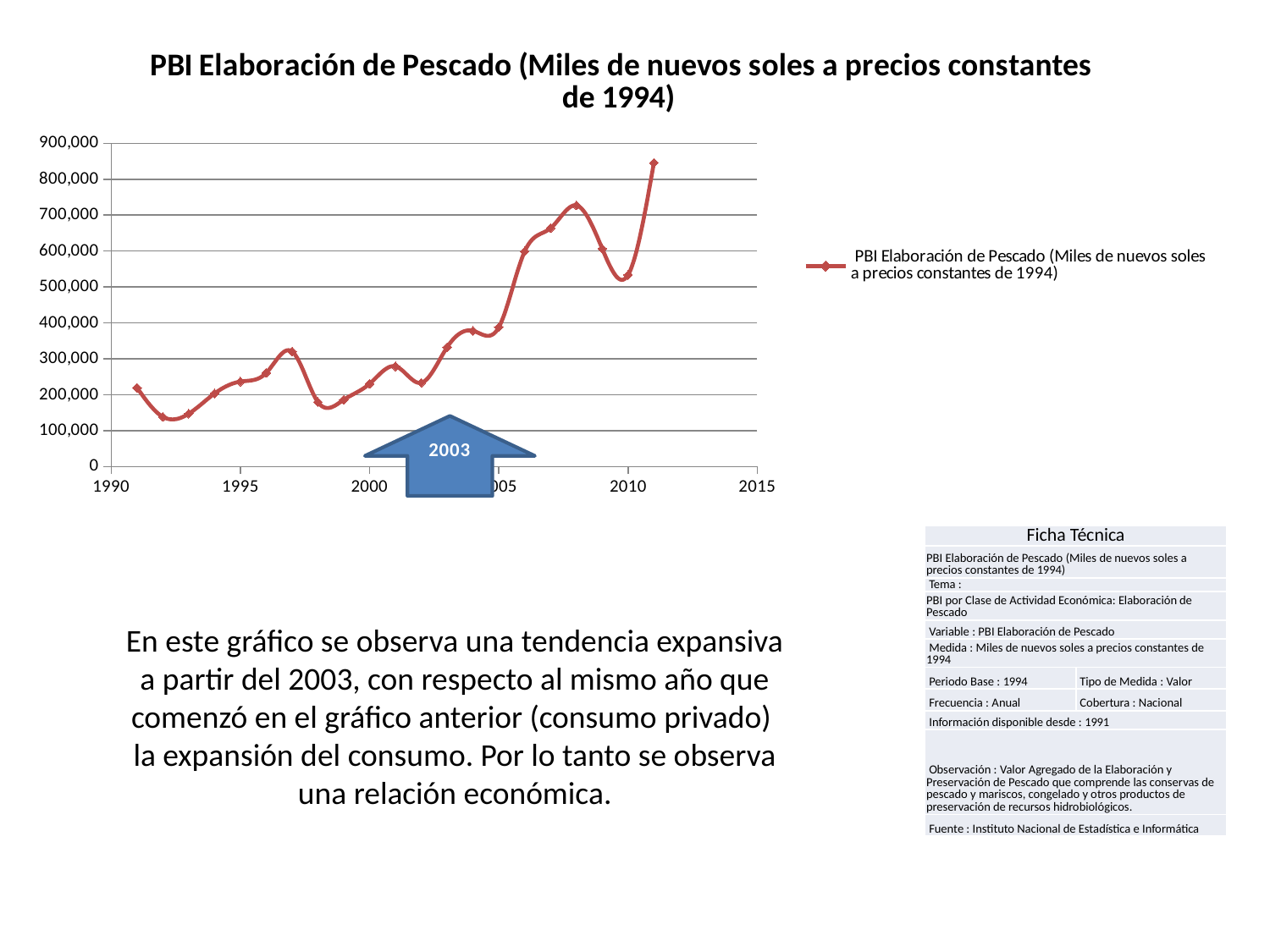
What kind of chart is shown on the slide? line chart Is the value for 1997 greater or less than 300,000? greater Overall, do the values rise or fall from 1991 to 2011? rise How many series does the chart legend list? 1 Is the value for 2010 greater or less than 500,000? greater Is the value for 2008 greater or less than 700,000? greater In which year does the series reach its highest value? 2011 Which year has the larger value, 2008 or 2010? 2008 Which year is highlighted by the arrow callout below the chart? 2003 What is the title of the chart? PBI Elaboración de Pescado (Miles de nuevos soles a precios constantes de 1994)